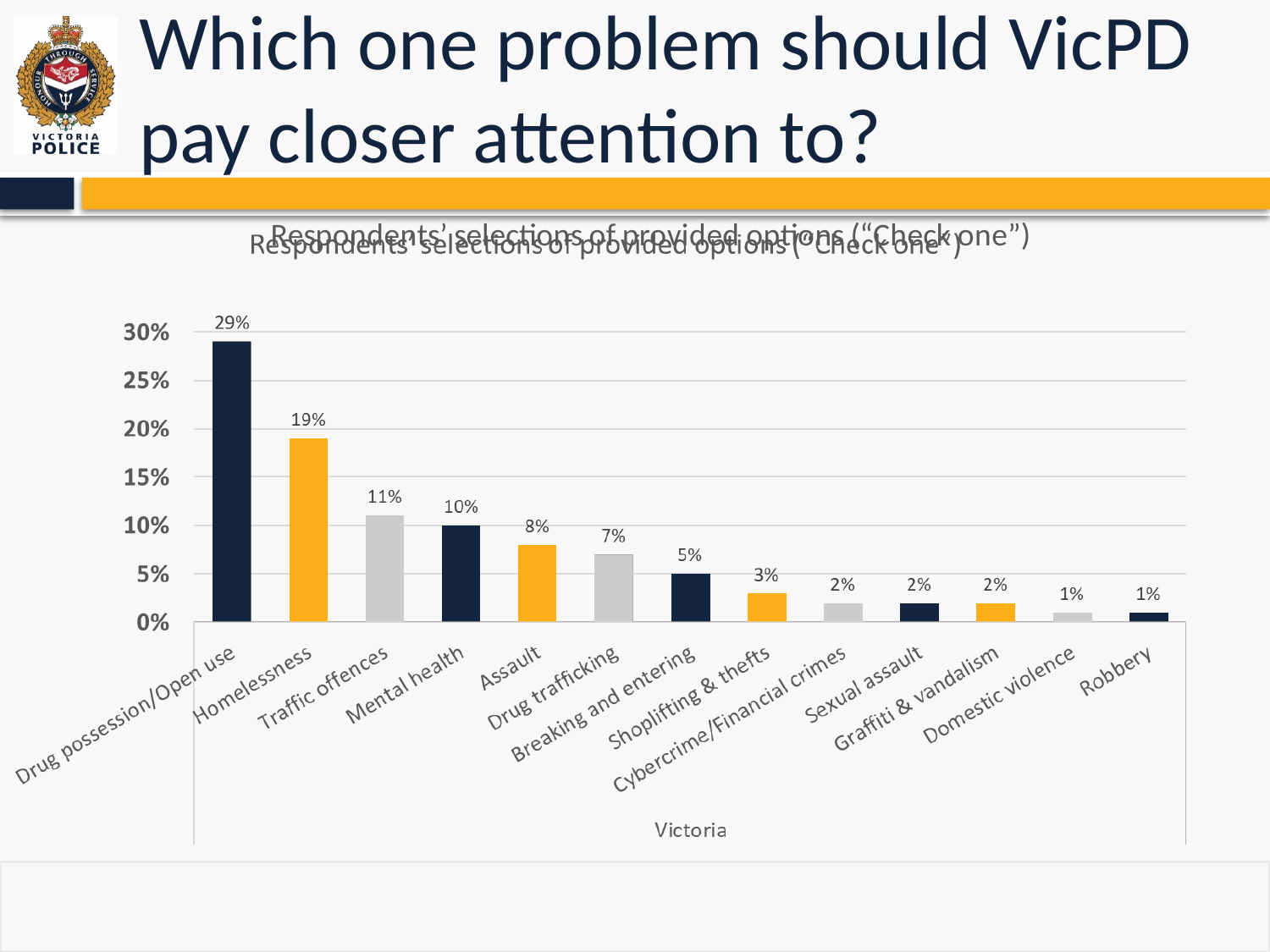
What value is shown for Homelessness? 19% What value is shown for Shoplifting & thefts? 3% What label appears below the x axis of the chart? Victoria Which is larger, the value for Drug trafficking or the value for Breaking and entering? Drug trafficking What kind of chart is shown on the slide? Bar chart What is the difference between the values for Drug possession/Open use and Homelessness? 10% What percentage of respondents selected Drug possession/Open use? 29% How many categories are shown on the x axis? 13 What percentage is shown for Mental health? 10% What is the difference between the values for Traffic offences and Assault? 3% Is the value for Homelessness greater or less than 15%? greater Which category has the highest value? Drug possession/Open use